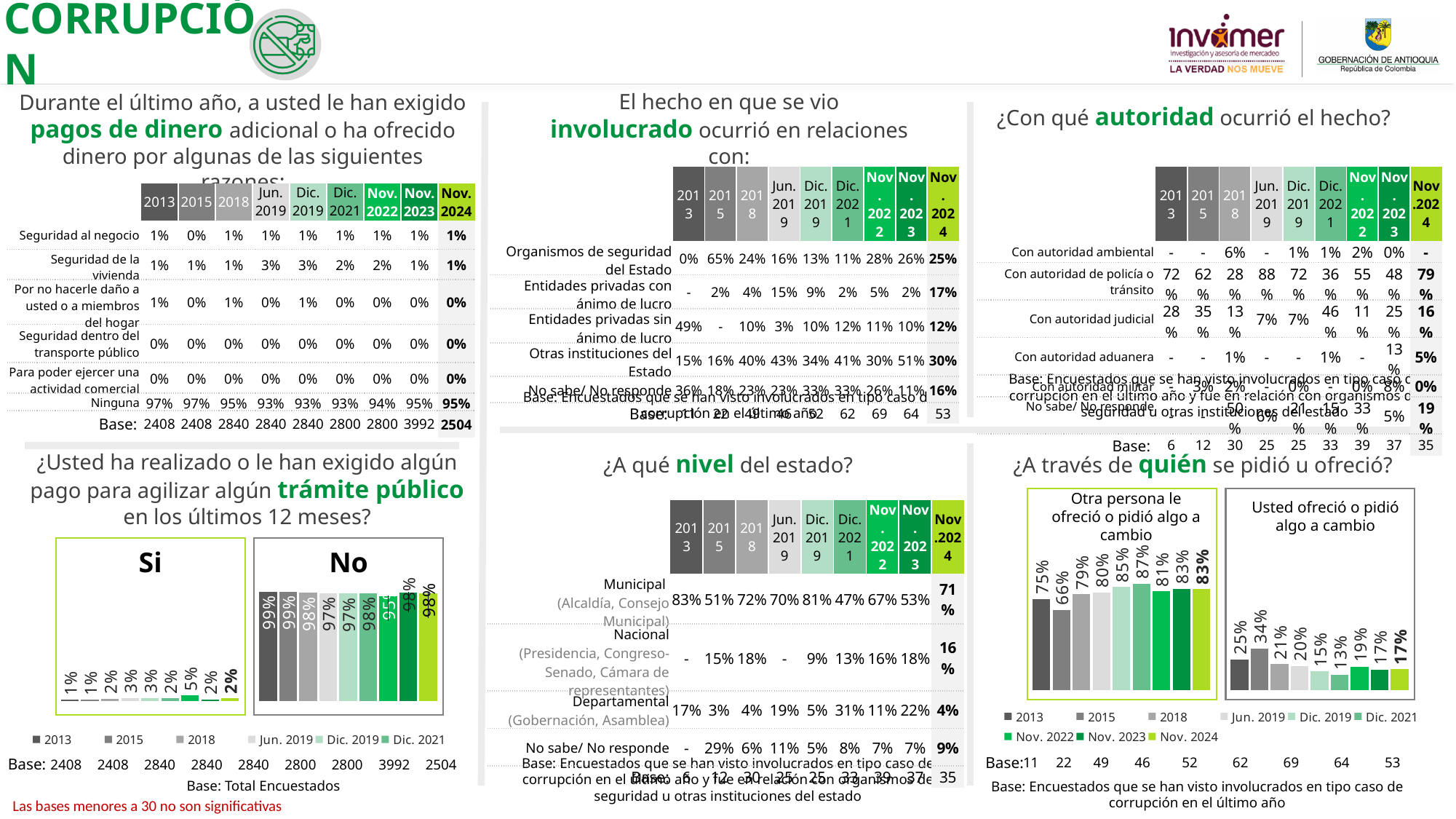
In the 'Otra persona le ofreció o pidió algo a cambio' panel of the chart '¿A través de quién se pidió u ofreció?', what is the value for 2015? 66% In the table '¿Con qué autoridad ocurrió el hecho?', what is the Nov. 2024 value for 'Con autoridad de policía o tránsito'? 79% In the 'No' panel of the chart about paying to speed up a 'trámite público', what is the value for Nov. 2024? 98% How many series does the legend of the chart '¿A través de quién se pidió u ofreció?' list? 9 In the 'Otra persona le ofreció o pidió algo a cambio' panel, which period has the highest value? Dic. 2021 In the 'Usted ofreció o pidió algo a cambio' panel, what is the difference between the 2015 value and the Dic. 2021 value? 21% In the 'No' panel of the 'trámite público' chart, which period has the lowest value? Nov. 2022 In the 'Si' panel of the 'trámite público' chart, which period has the highest value? Nov. 2022 In the 'Otra persona le ofreció o pidió algo a cambio' panel, is the value for 2013 or for Dic. 2019 larger? Dic. 2019 In the 'Si' panel of the chart '¿Usted ha realizado o le han exigido algún pago para agilizar algún trámite público en los últimos 12 meses?', what is the value for Nov. 2022? 5% In the 'Usted ofreció o pidió algo a cambio' panel of the chart '¿A través de quién se pidió u ofreció?', what is the value for Nov. 2024? 17% What kind of chart is used for '¿A través de quién se pidió u ofreció?'? bar chart